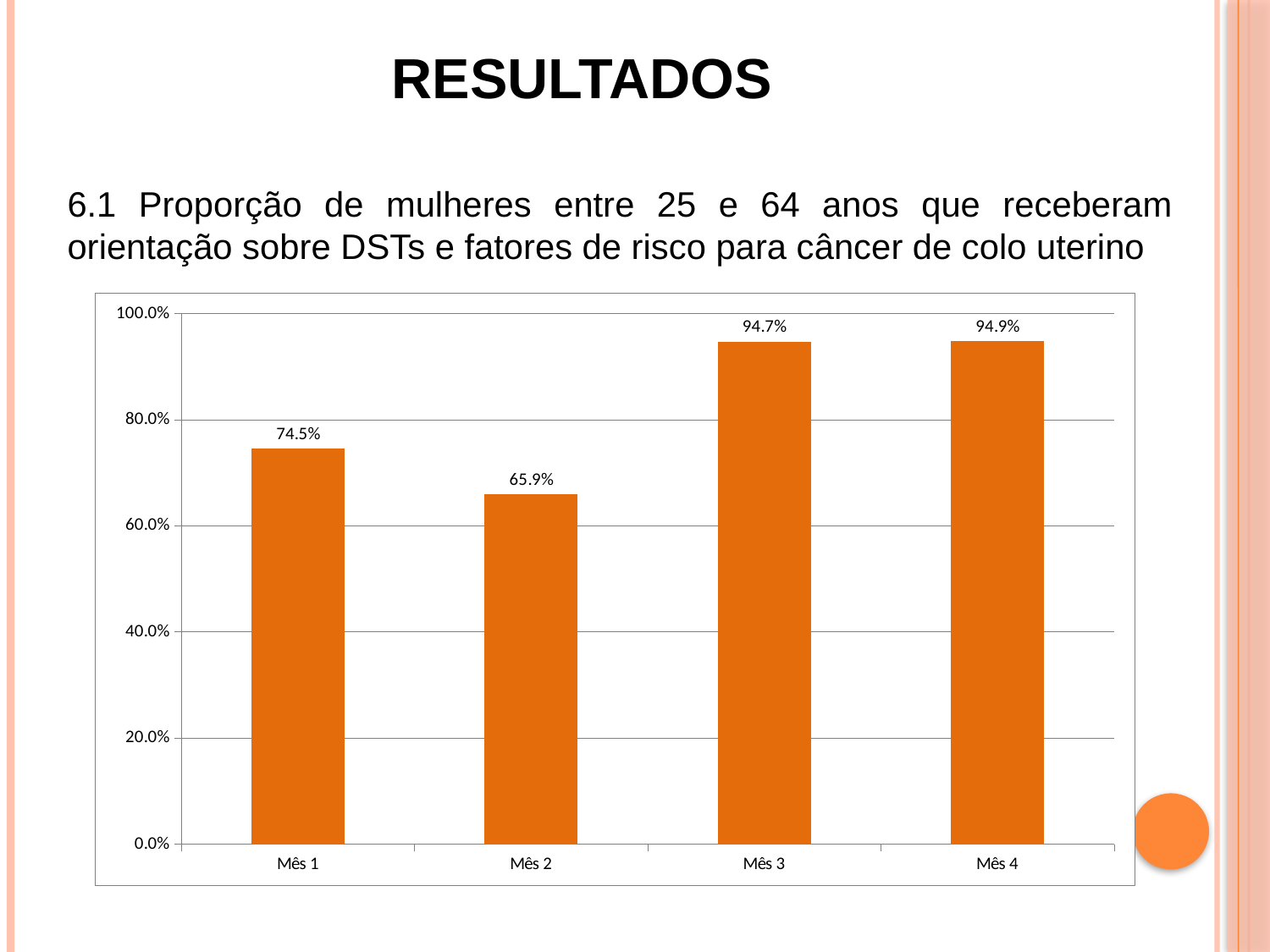
What is the value for Mês 4? 94.9% What is the value for Mês 3? 94.7% What is the value for Mês 2? 65.9% What is the value for Mês 1? 74.5% What is the difference between the values for Mês 1 and Mês 2? 8.6% What is the difference between the values for Mês 3 and Mês 2? 28.8% Is the value for Mês 2 greater or less than 80.0%? less What colour are the bars in the chart? orange Which is larger, the value for Mês 1 or the value for Mês 3? Mês 3 How many months are shown on the x axis? 4 What kind of chart is shown on the slide? bar chart Which month has the lowest value? Mês 2